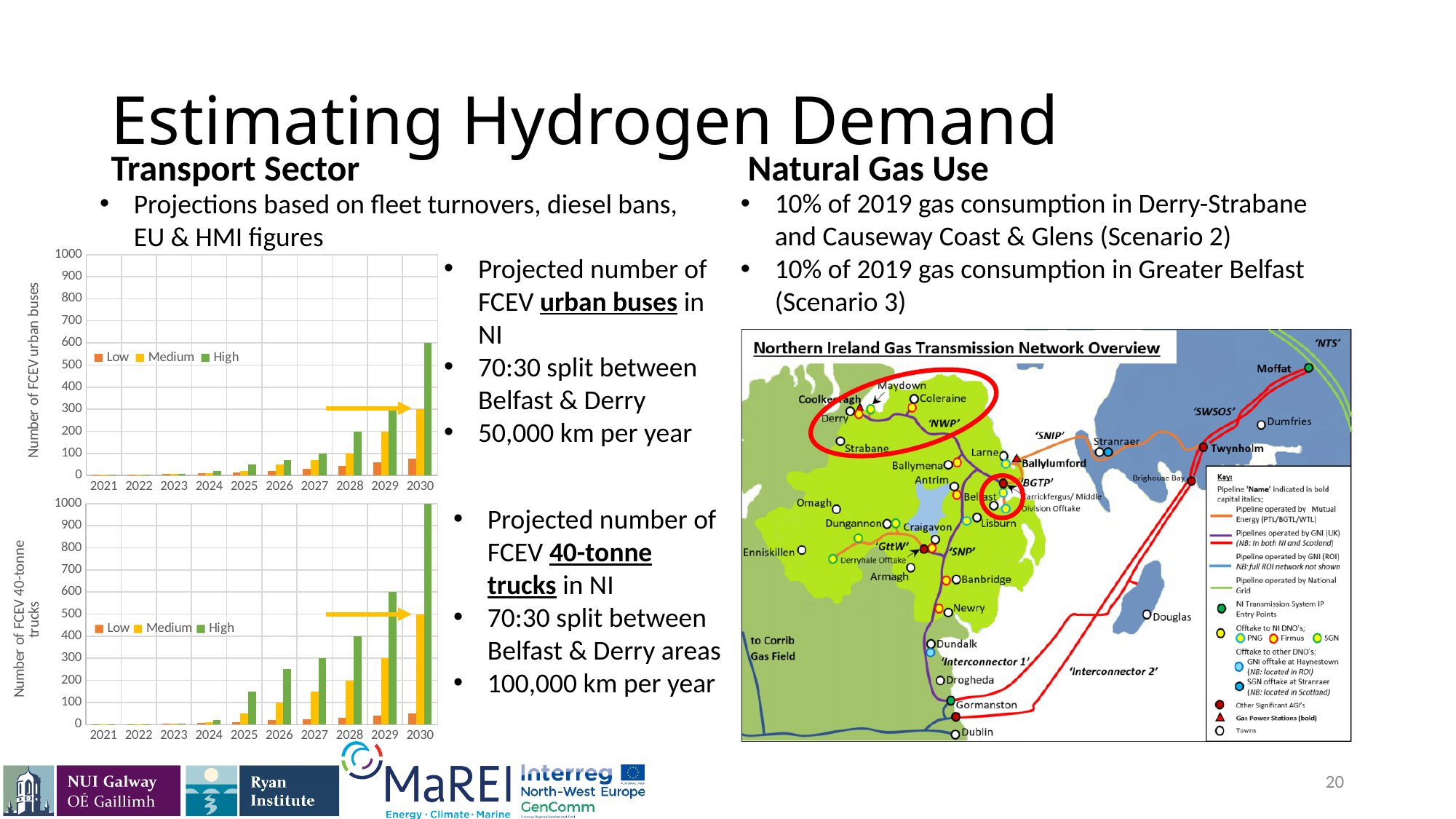
In the top chart, 'Number of FCEV urban buses', do the High values rise or fall from 2021 to 2030? rise In the bottom chart, 'Number of FCEV 40-tonne trucks', is the Medium value for 2030 greater or less than 400? greater In the top chart, 'Number of FCEV urban buses', how many years are shown on the x axis? 10 In the top chart, 'Number of FCEV urban buses', is the Low value for 2030 greater or less than 100? less What kind of chart is the top chart, 'Number of FCEV urban buses'? bar chart In the bottom chart, 'Number of FCEV 40-tonne trucks', which is larger: the High value for 2028 or the High value for 2026? High value for 2028 How many series does the legend list in the bottom chart, 'Number of FCEV 40-tonne trucks'? 3 In the bottom chart, 'Number of FCEV 40-tonne trucks', what is the High value for 2030? 1000 In the top chart, 'Number of FCEV urban buses', is the High value for 2030 greater or less than 500? greater In the top chart, 'Number of FCEV urban buses', which series has the highest value in 2030? High What colour represents the Medium series in the top chart, 'Number of FCEV urban buses'? yellow